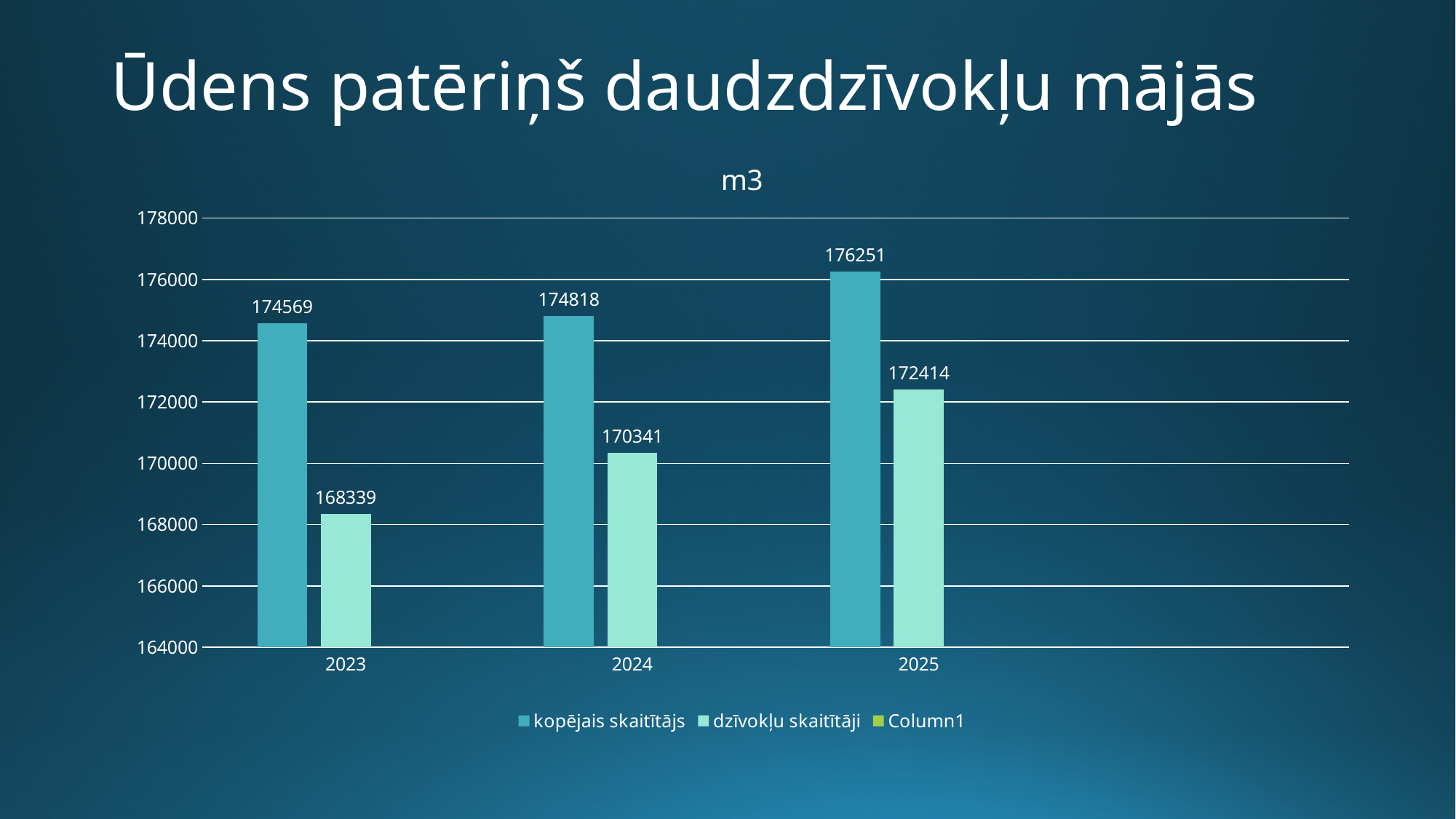
What is the value for kopējais skaitītājs in 2023? 174569 What is the difference between kopējais skaitītājs in 2025 and in 2024? 1433 In which year is dzīvokļu skaitītāji lowest? 2023 How many years are shown on the x axis? 3 What is the value for dzīvokļu skaitītāji in 2025? 172414 What is the difference between kopējais skaitītājs and dzīvokļu skaitītāji in 2023? 6230 In which year is kopējais skaitītājs highest? 2025 What kind of chart is shown on the slide? bar chart Which is larger in 2024: kopējais skaitītājs or dzīvokļu skaitītāji? kopējais skaitītājs Is the value for dzīvokļu skaitītāji in 2025 greater or less than 172000? greater What is the value for dzīvokļu skaitītāji in 2024? 170341 How many series does the legend list? 3